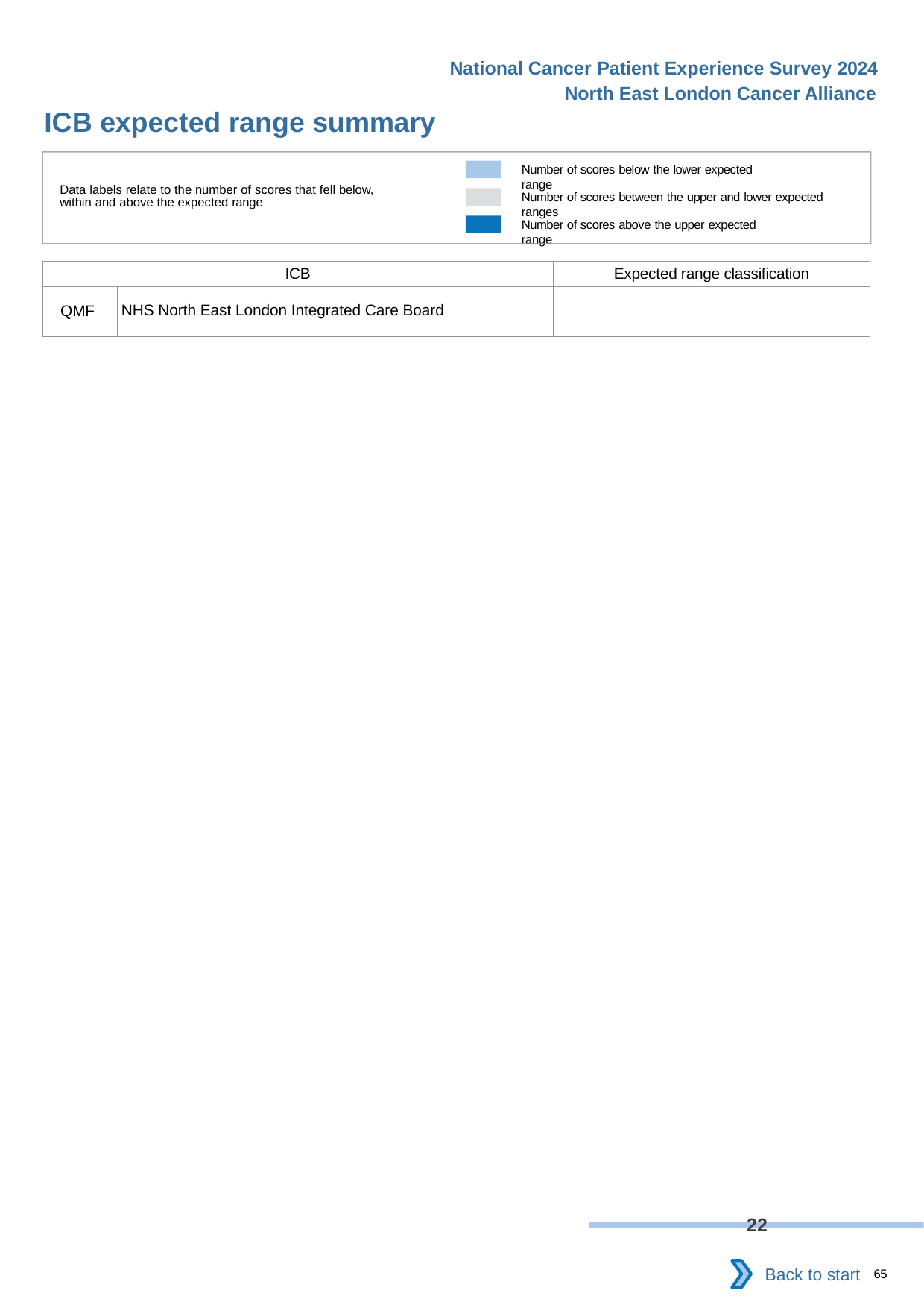
What data label is printed on the bar shown near the bottom of the slide? 22 According to the legend, what does the darkest blue colour represent? Number of scores above the upper expected range How many entries does the legend in the expected range summary list? 3 Which ICB is listed in the table on the slide? NHS North East London Integrated Care Board What kind of chart is shown on the slide? bar chart